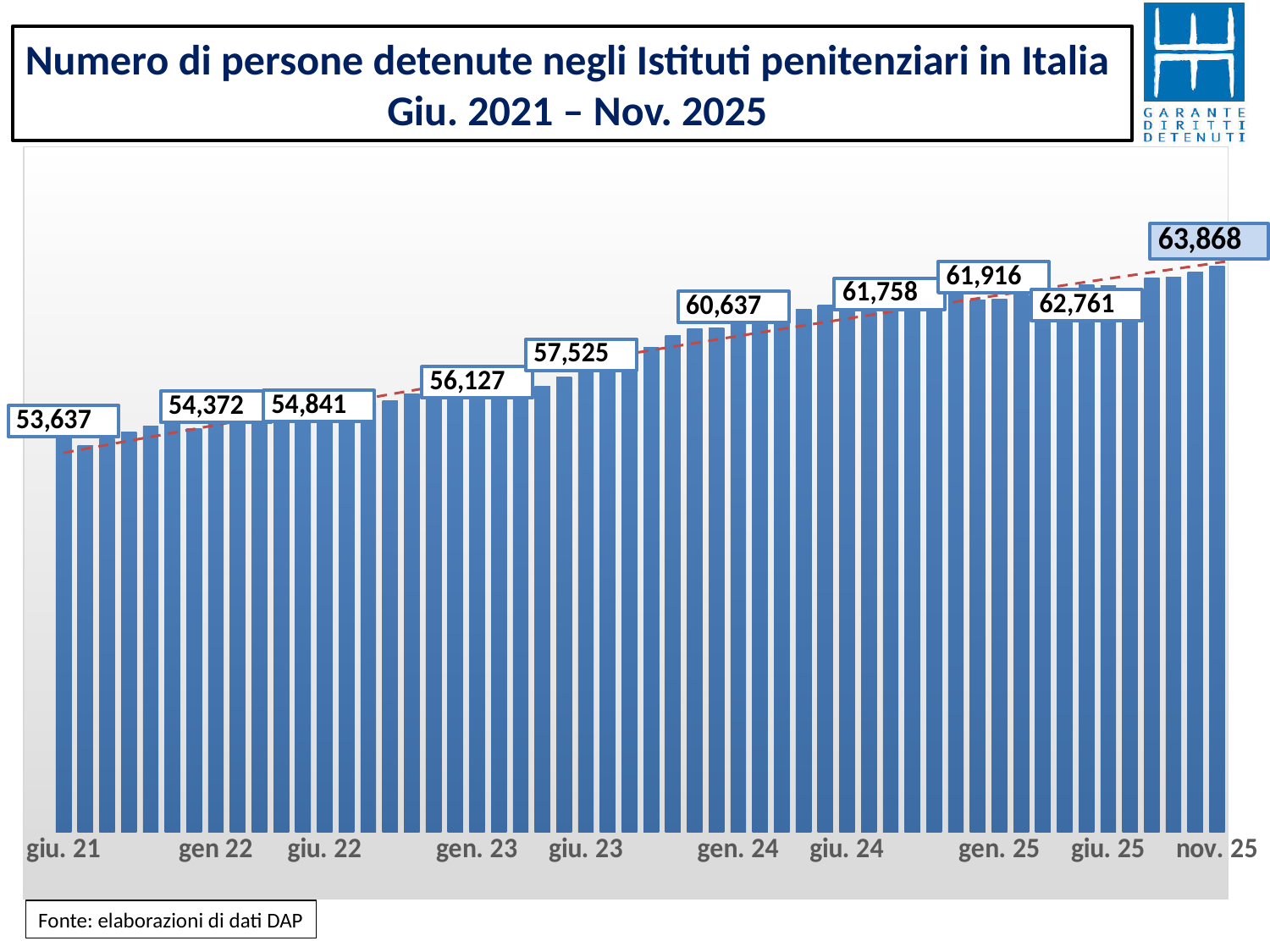
Do the values generally rise or fall from giu. 21 to nov. 25? rise What kind of chart is shown on the slide? bar chart What is the value shown for gen. 23? 56,127 What is the value shown for giu. 22? 54,841 Which labelled month has the lowest value? giu. 21 What is the value shown for gen. 24? 60,637 What is the value shown for giu. 21? 53,637 What is the value shown for gen 22? 54,372 What is the value shown for nov. 25? 63,868 Which labelled month has the highest value? nov. 25 What is the difference between the values for nov. 25 and giu. 21? 10,231 Which is larger, the value for giu. 24 or the value for gen. 25? gen. 25